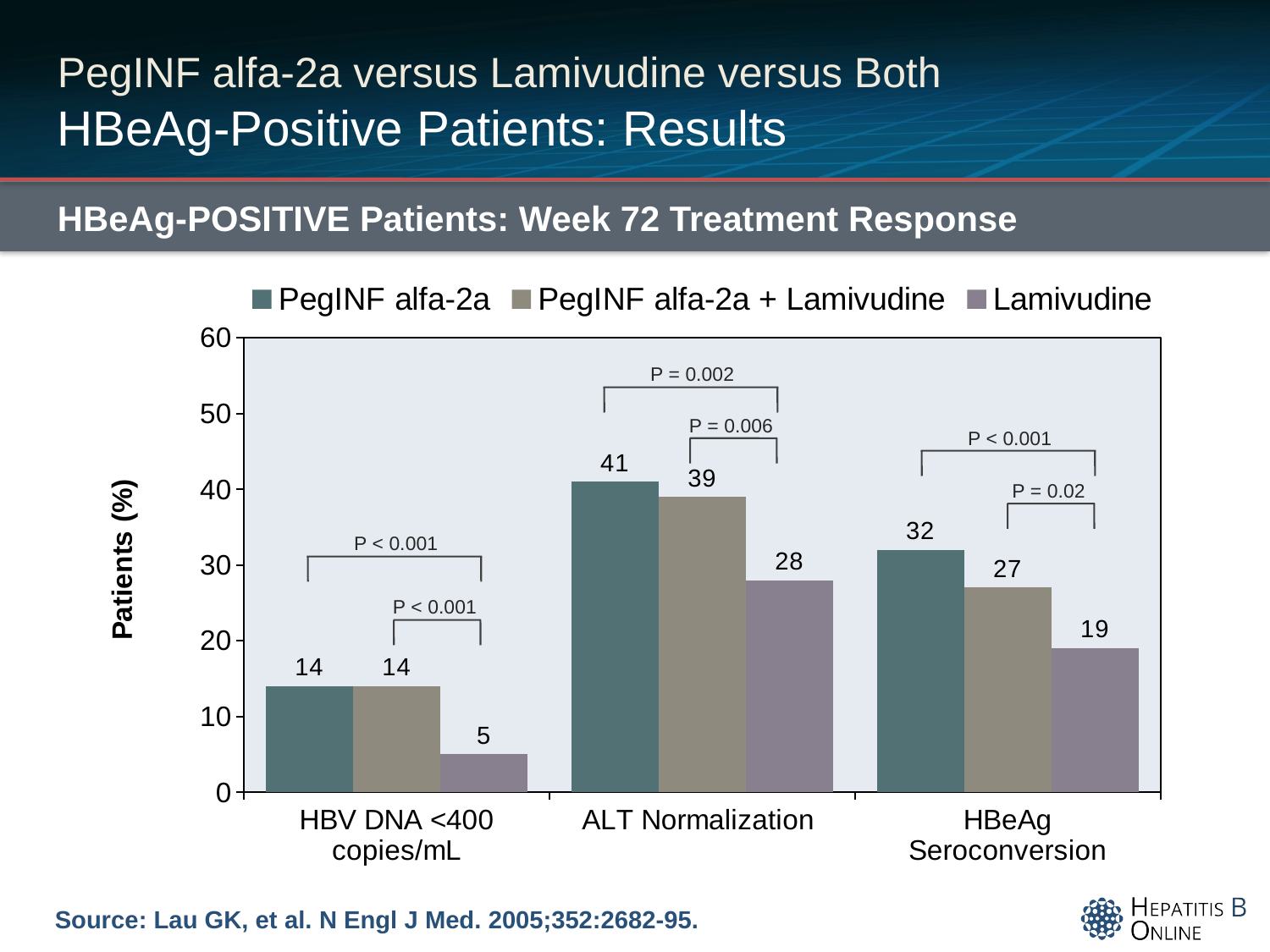
Which series has the lowest value in the HBeAg Seroconversion category? Lamivudine How many series does the legend list? 3 Which category has the highest value for the Lamivudine series? ALT Normalization What is the value for PegINF alfa-2a + Lamivudine in the HBeAg Seroconversion category? 27 How many categories are shown on the x axis? 3 What is the value for Lamivudine in the HBV DNA <400 copies/mL category? 5 What P value is shown between PegINF alfa-2a + Lamivudine and Lamivudine in the HBeAg Seroconversion category? P = 0.02 What is the difference between the PegINF alfa-2a and Lamivudine values in the HBeAg Seroconversion category? 13 What is the value for PegINF alfa-2a in the ALT Normalization category? 41 Which is larger in the ALT Normalization category: PegINF alfa-2a + Lamivudine or Lamivudine? PegINF alfa-2a + Lamivudine What is the label of the y axis? Patients (%) What kind of chart is shown on the slide? Bar chart